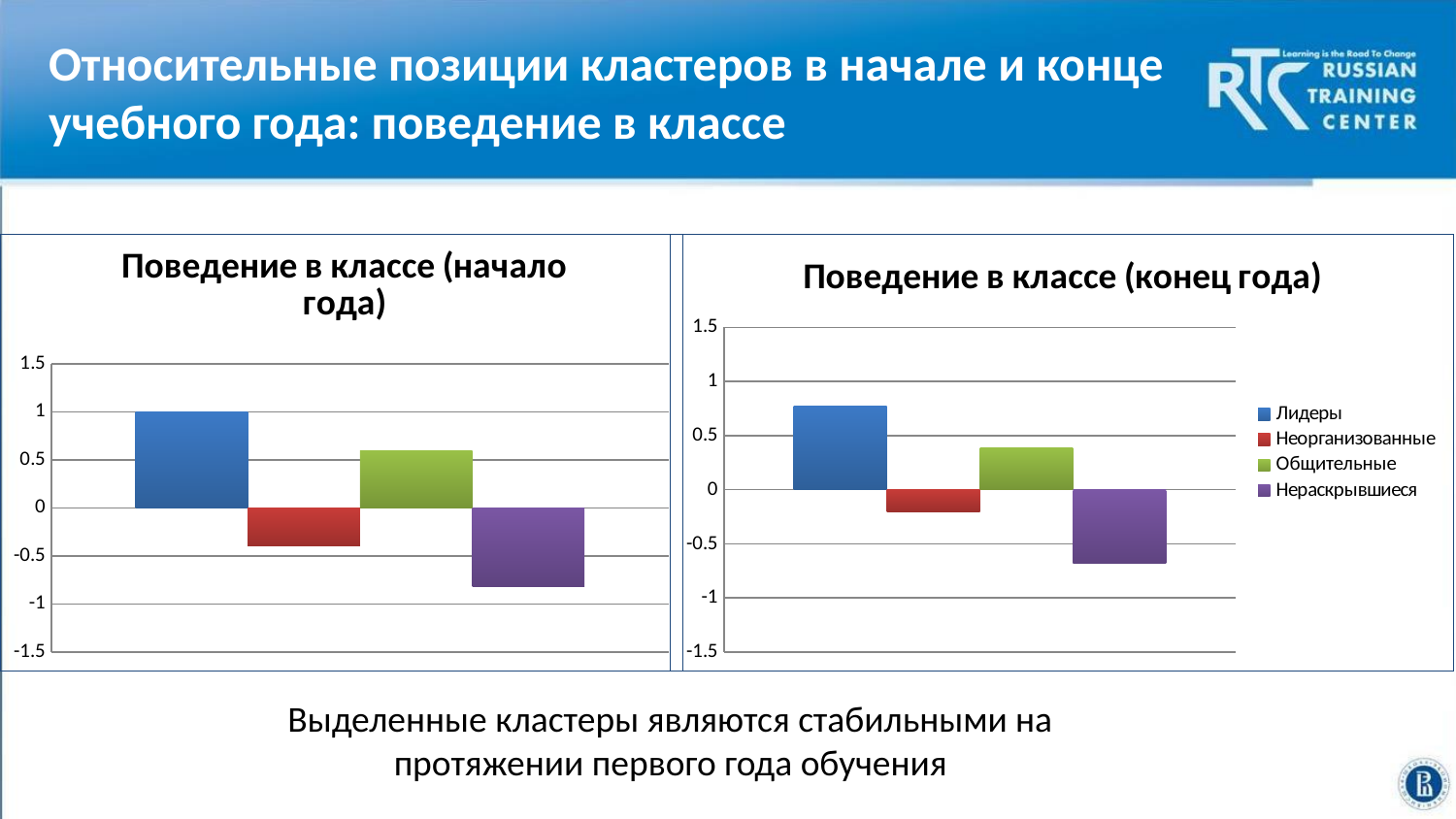
In the chart titled "Поведение в классе (начало года)", is the value for Неорганизованные greater or less than -0.5? greater How many series does the legend on the right chart list? 4 In the chart titled "Поведение в классе (конец года)", which cluster has the highest value? Лидеры In the chart titled "Поведение в классе (конец года)", which cluster has the lowest value? Нераскрывшиеся In the chart titled "Поведение в классе (начало года)", which cluster has the lowest value? Нераскрывшиеся What kind of chart is "Поведение в классе (начало года)"? bar chart In the legend of the right chart, which cluster is shown in green? Общительные In the chart titled "Поведение в классе (начало года)", is the value for Общительные greater or less than 0.5? greater In the chart titled "Поведение в классе (конец года)", is the value for Лидеры greater or less than 0.5? greater In the chart titled "Поведение в классе (начало года)", which cluster has the highest value? Лидеры In the chart titled "Поведение в классе (конец года)", which is larger, the value for Общительные or the value for Неорганизованные? Общительные